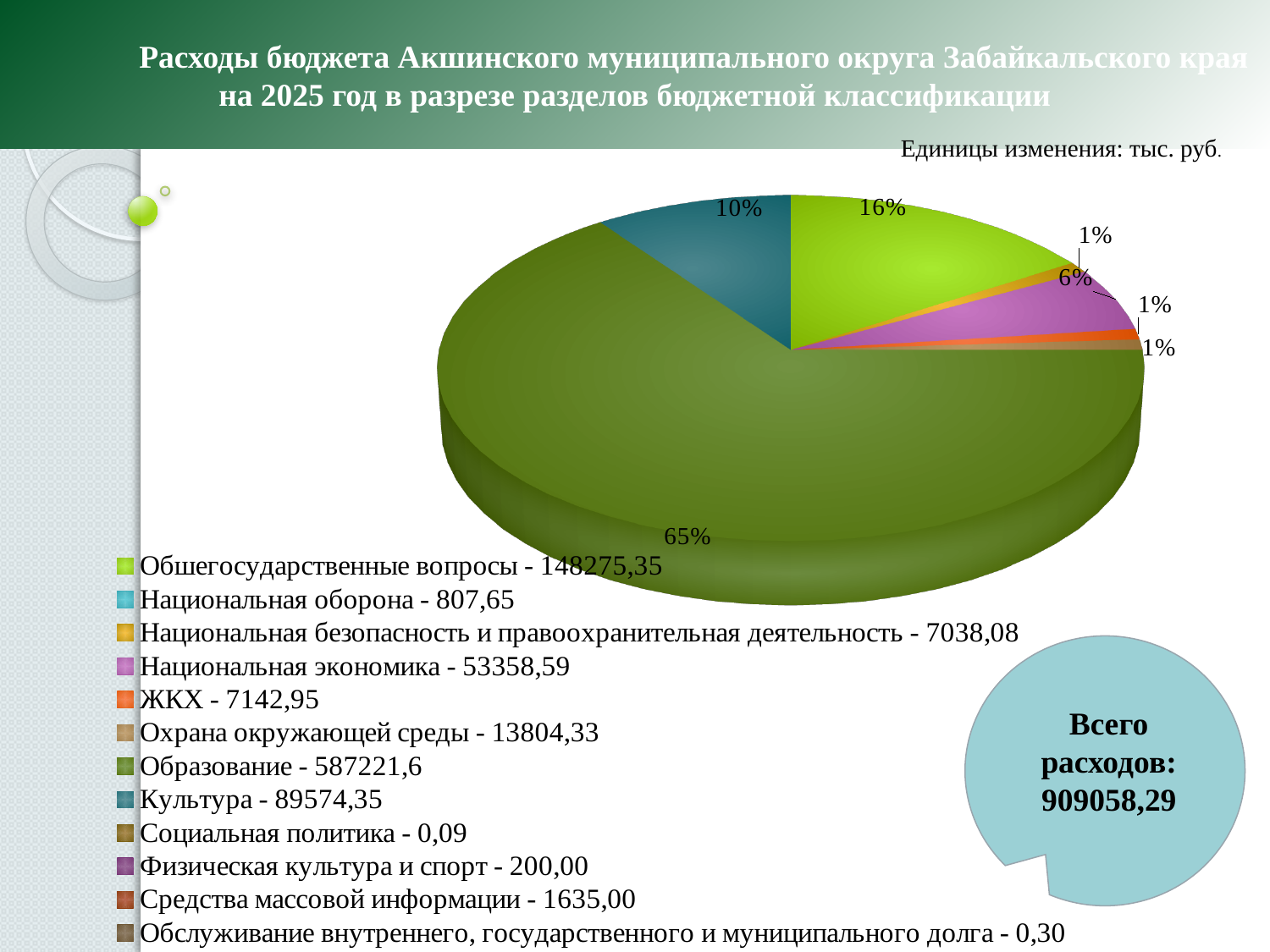
Which category has the smallest value in the legend? Социальная политика Which is larger, the value for Охрана окружающей среды or the value for ЖКХ? Охрана окружающей среды What total expenditure (Всего расходов) is shown on the slide? 909058,29 Which category has the largest share of the pie? Образование What share of the pie does Общегосударственные вопросы take? 16% What is the value for Национальная оборона according to the legend? 807,65 How many categories does the legend of the pie chart list? 12 What is the difference between the values for Образование and Культура? 497647,25 What share of the pie does Образование take? 65% What is the value for Образование according to the legend? 587221,6 What is the value for Культура according to the legend? 89574,35 What kind of chart is shown on the slide? pie chart